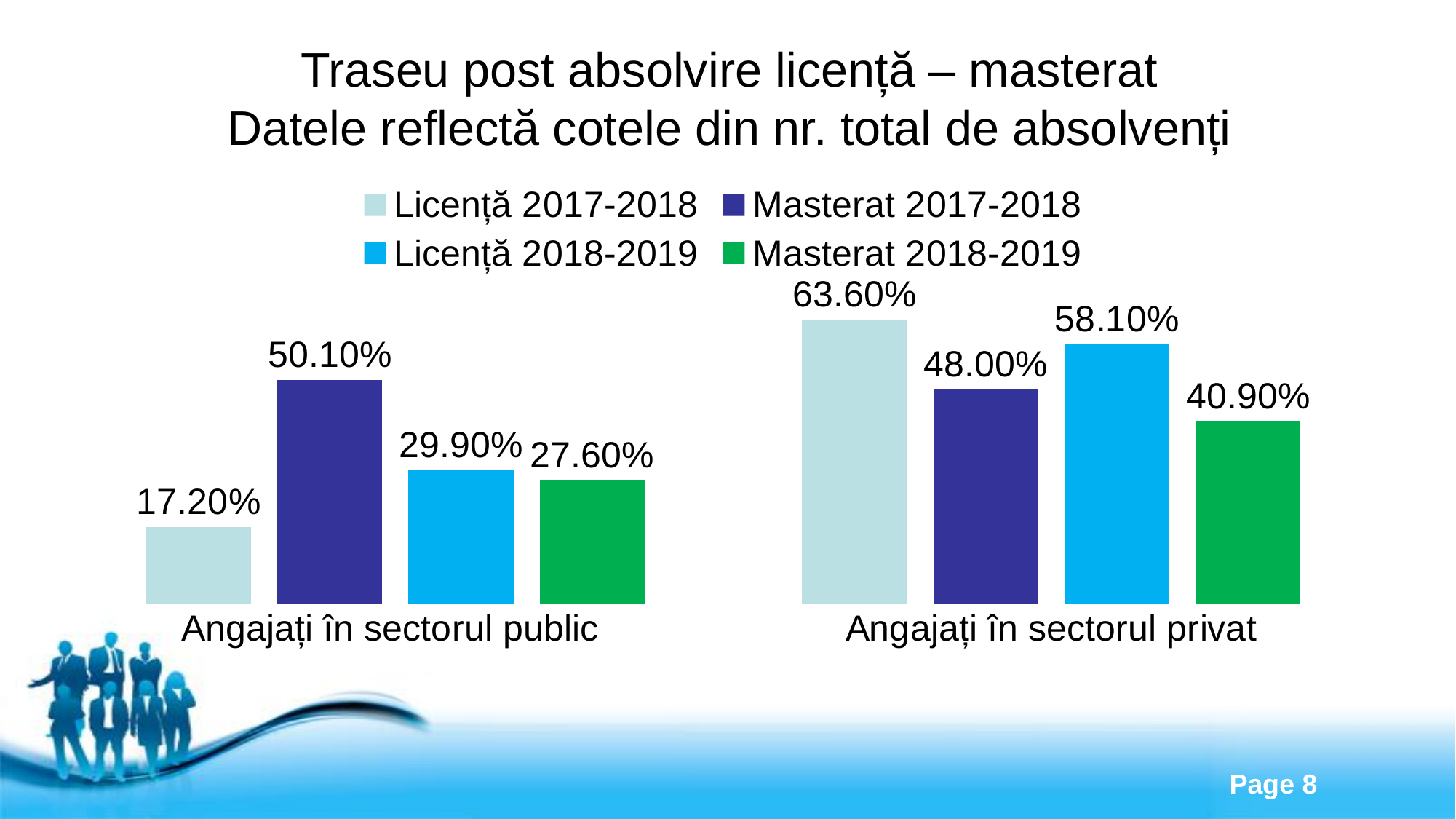
What is the difference between Masterat 2017-2018 and Masterat 2018-2019 in the 'Angajați în sectorul public' category? 22.50% How many categories are shown on the x axis? 2 What is the value for Licență 2018-2019 in the 'Angajați în sectorul public' category? 29.90% How many series does the legend list? 4 Which series has the lowest value in the 'Angajați în sectorul public' category? Licență 2017-2018 Which series has the highest value in the 'Angajați în sectorul privat' category? Licență 2017-2018 What is the value for Licență 2017-2018 in the 'Angajați în sectorul public' category? 17.20% What kind of chart is shown on the slide? Bar chart What is the difference between Licență 2017-2018 and Licență 2018-2019 in the 'Angajați în sectorul privat' category? 5.50% What is the value for Masterat 2018-2019 in the 'Angajați în sectorul privat' category? 40.90% What colour represents the Licență 2018-2019 series? Bright blue Which is larger: Masterat 2017-2018 in the public sector or Masterat 2017-2018 in the private sector? Public sector (50.10%)